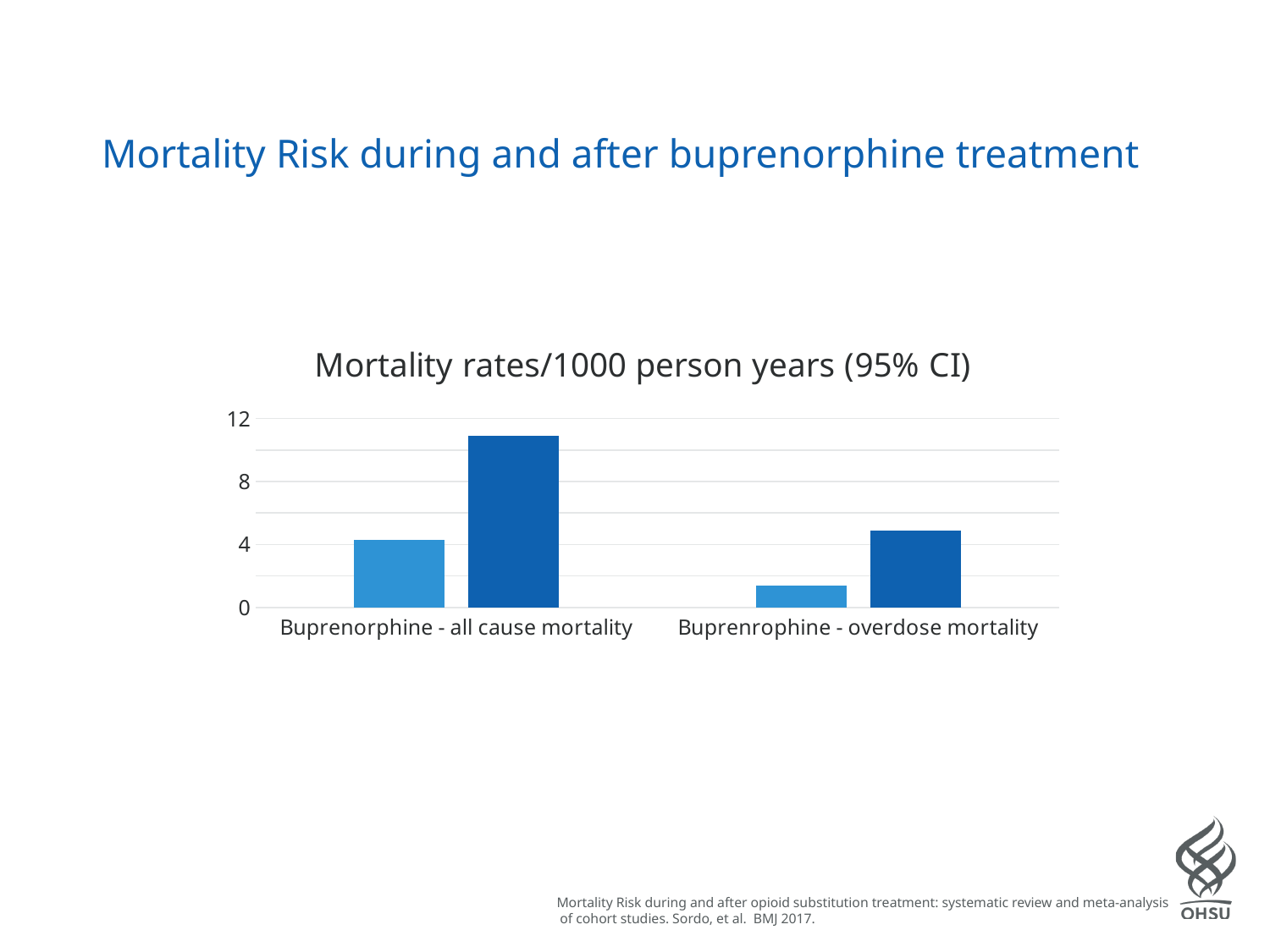
What is the title of the chart? Mortality rates/1000 person years (95% CI) What type of chart is shown on the slide? bar chart Which category contains the shortest bar in the chart? Buprenrophine - overdose mortality How many bars are plotted in the chart in total? 4 For Buprenrophine - overdose mortality, is the lighter blue bar greater or less than 4? less For Buprenrophine - overdose mortality, is the darker blue bar greater or less than 4? greater How many categories are shown on the x axis of the chart? 2 Which category contains the tallest bar in the chart? Buprenorphine - all cause mortality For Buprenorphine - all cause mortality, is the darker blue bar greater or less than 8? greater What is the highest value shown on the y axis of the chart? 12 In the Buprenorphine - all cause mortality category, which bar is taller, the lighter blue bar or the darker blue bar? the darker blue bar